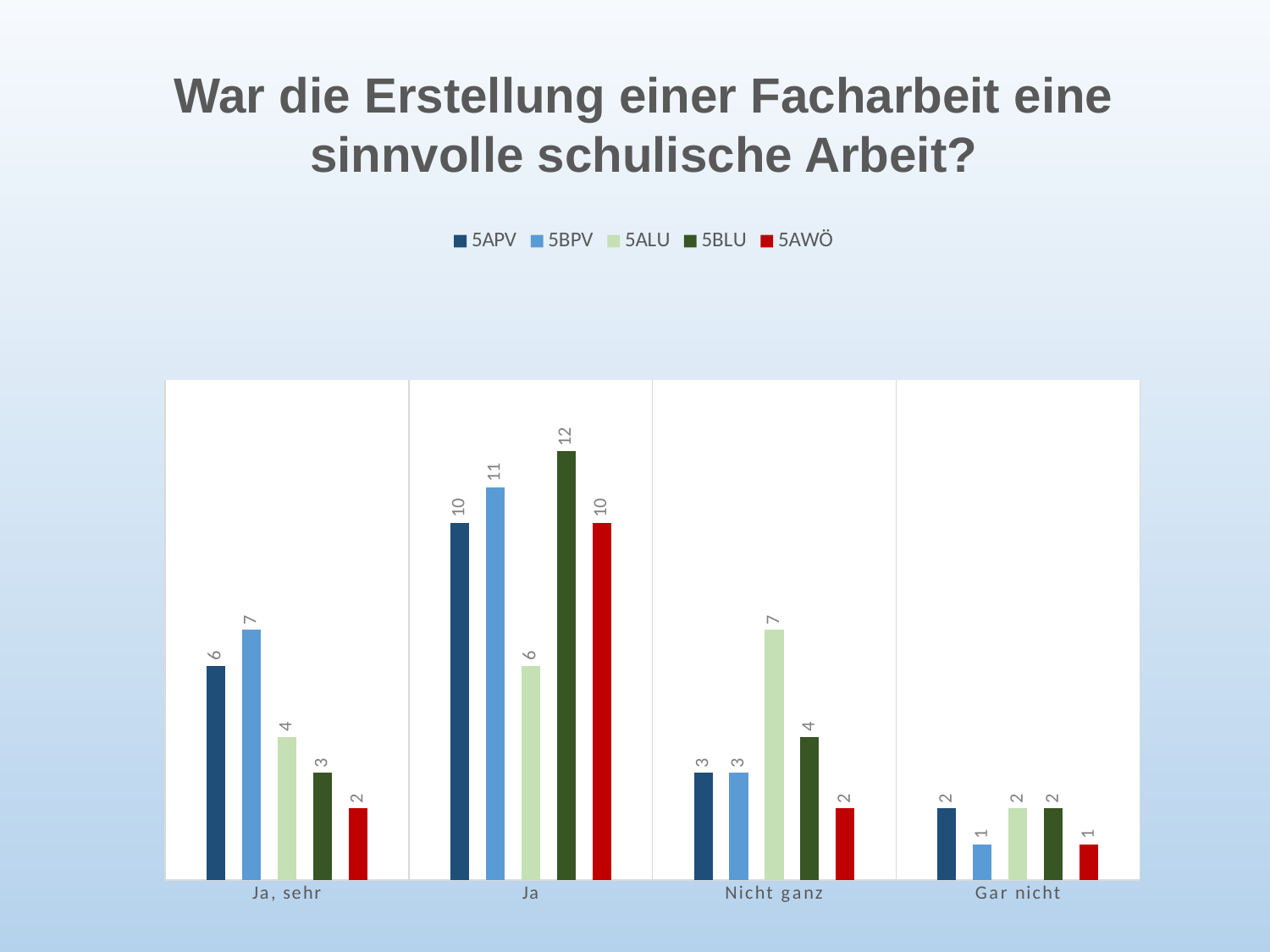
What is the title of the chart? War die Erstellung einer Facharbeit eine sinnvolle schulische Arbeit? What value does 5ALU have for "Nicht ganz"? 7 Which is larger for "Nicht ganz": the value for 5ALU or the value for 5BLU? 5ALU What is the difference between the 5BPV and 5APV values for "Ja, sehr"? 1 What kind of chart is shown on the slide? bar chart What value does 5BLU have for the category "Ja"? 12 How many categories are shown on the x axis? 4 What is the total of the five series' values for the "Gar nicht" category? 8 What value does 5AWÖ have for "Ja, sehr"? 2 How many series does the legend list? 5 Which series has the highest value in the "Ja" category? 5BLU Which series has the lowest value in the "Gar nicht" category? 5BPV and 5AWÖ (both 1)